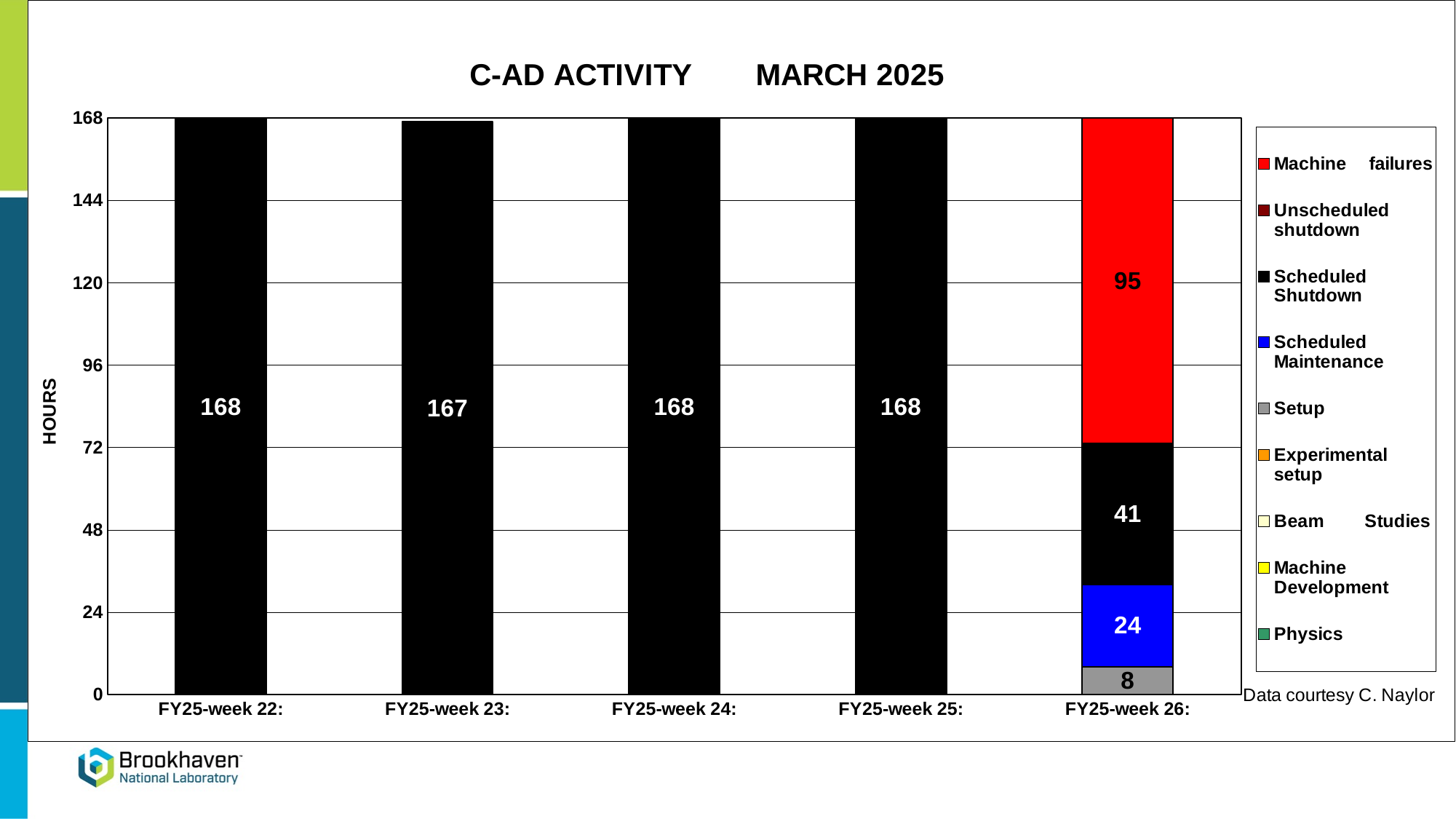
What is the Scheduled Shutdown value for FY25-week 26? 41 What kind of chart is shown on the slide? Stacked bar chart What is the total of the stacked bar for FY25-week 26? 168 What is the title of the chart? C-AD ACTIVITY MARCH 2025 Which week has the lowest Scheduled Shutdown value? FY25-week 26: What is the Scheduled Maintenance value for FY25-week 26? 24 How many series does the legend list? 9 How many hours of Machine failures are shown for FY25-week 26? 95 What is the difference between the Machine failures and Scheduled Shutdown values for FY25-week 26? 54 How many weeks (categories) are shown on the x axis? 5 What is the Setup value for FY25-week 26? 8 What is the Scheduled Shutdown value for FY25-week 23? 167